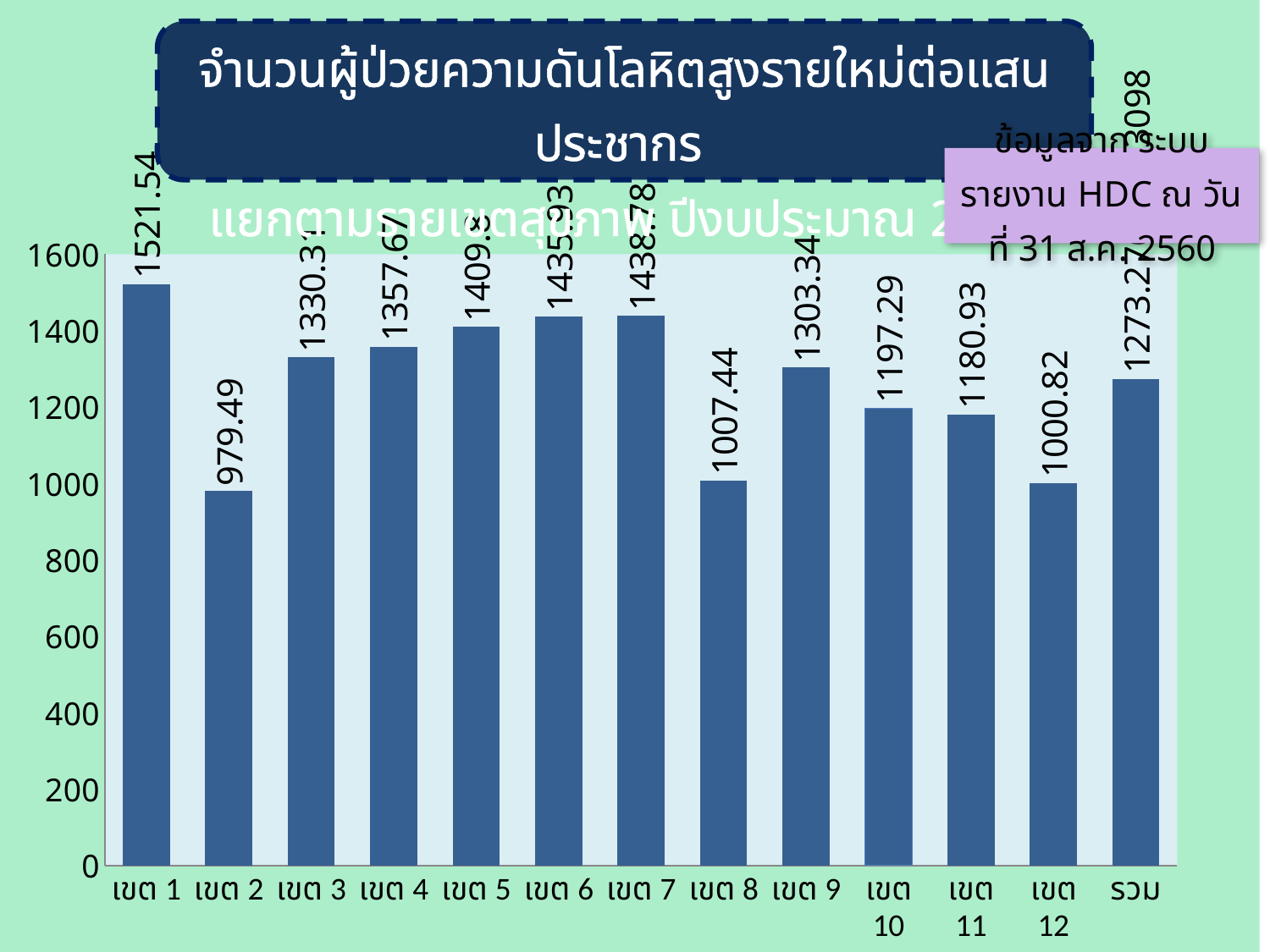
Is the value for เขต 6 greater or less than 1400? greater What is the value for เขต 12? 1000.82 Which category has the highest value? เขต 1 What is the value for เขต 9? 1303.34 What kind of chart is shown on the slide? bar chart What is the value for เขต 1? 1521.54 Which category has the lowest value? เขต 2 What is the value for เขต 7? 1438.78 What is the value for เขต 2? 979.49 Which is larger, the value for เขต 10 or the value for เขต 11? เขต 10 What is the difference between the values for เขต 1 and เขต 2? 542.05 How many categories are shown on the x axis? 13